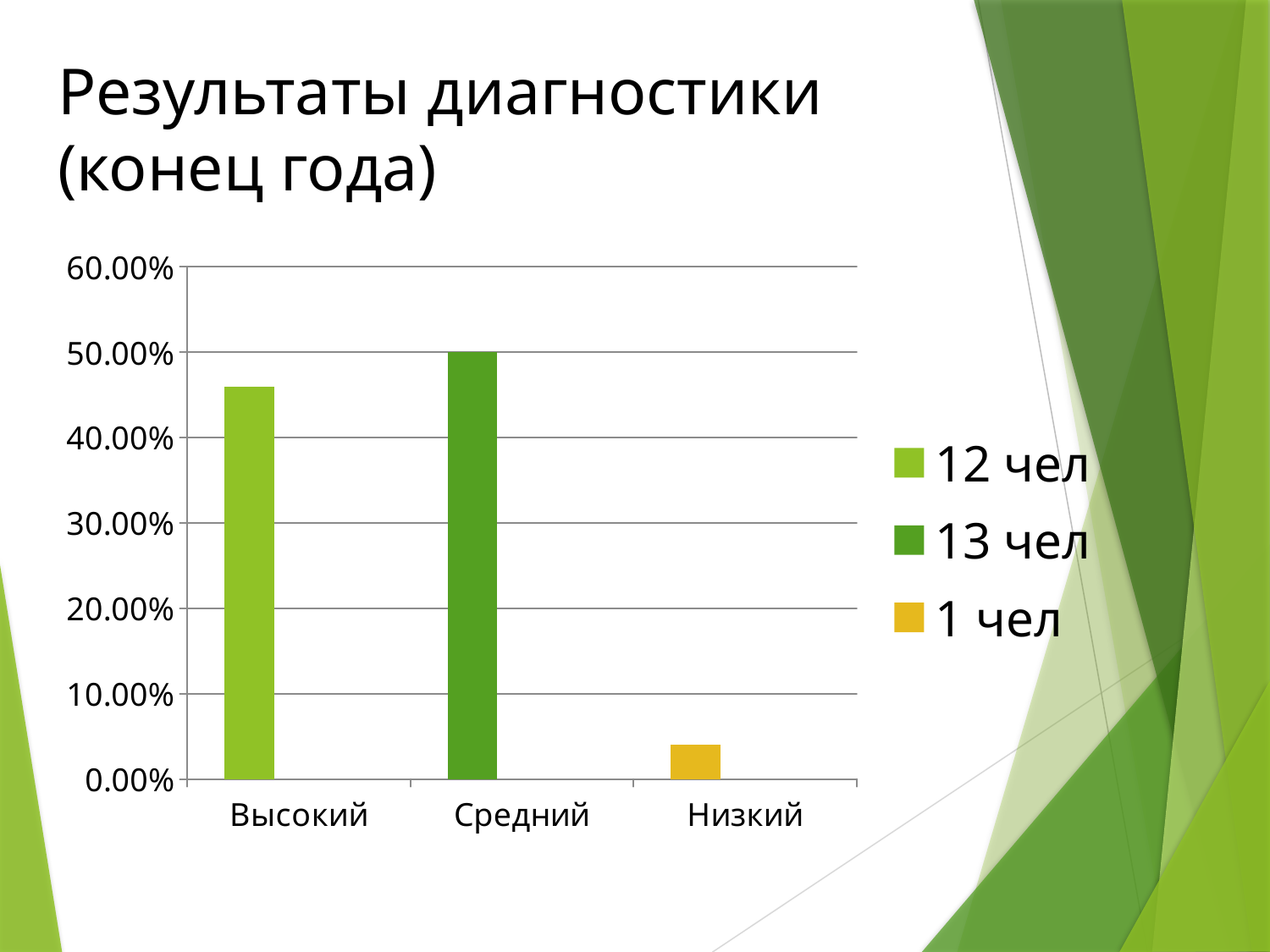
How many categories are shown on the x axis of the chart? 3 What is the title of the slide containing the chart? Результаты диагностики (конец года) Which category has the lowest value in the chart? Низкий Which category has the highest value in the chart? Средний Which legend entry corresponds to the yellow bar? 1 чел What kind of chart is shown on the slide? bar chart How many entries does the chart's legend list? 3 Which is larger, the value for Высокий or the value for Средний? Средний What is the value for Средний? 50.00% Is the value for Высокий greater or less than 40.00%? greater Which is larger, the value for Высокий or the value for Низкий? Высокий Is the value for Низкий greater or less than 10.00%? less